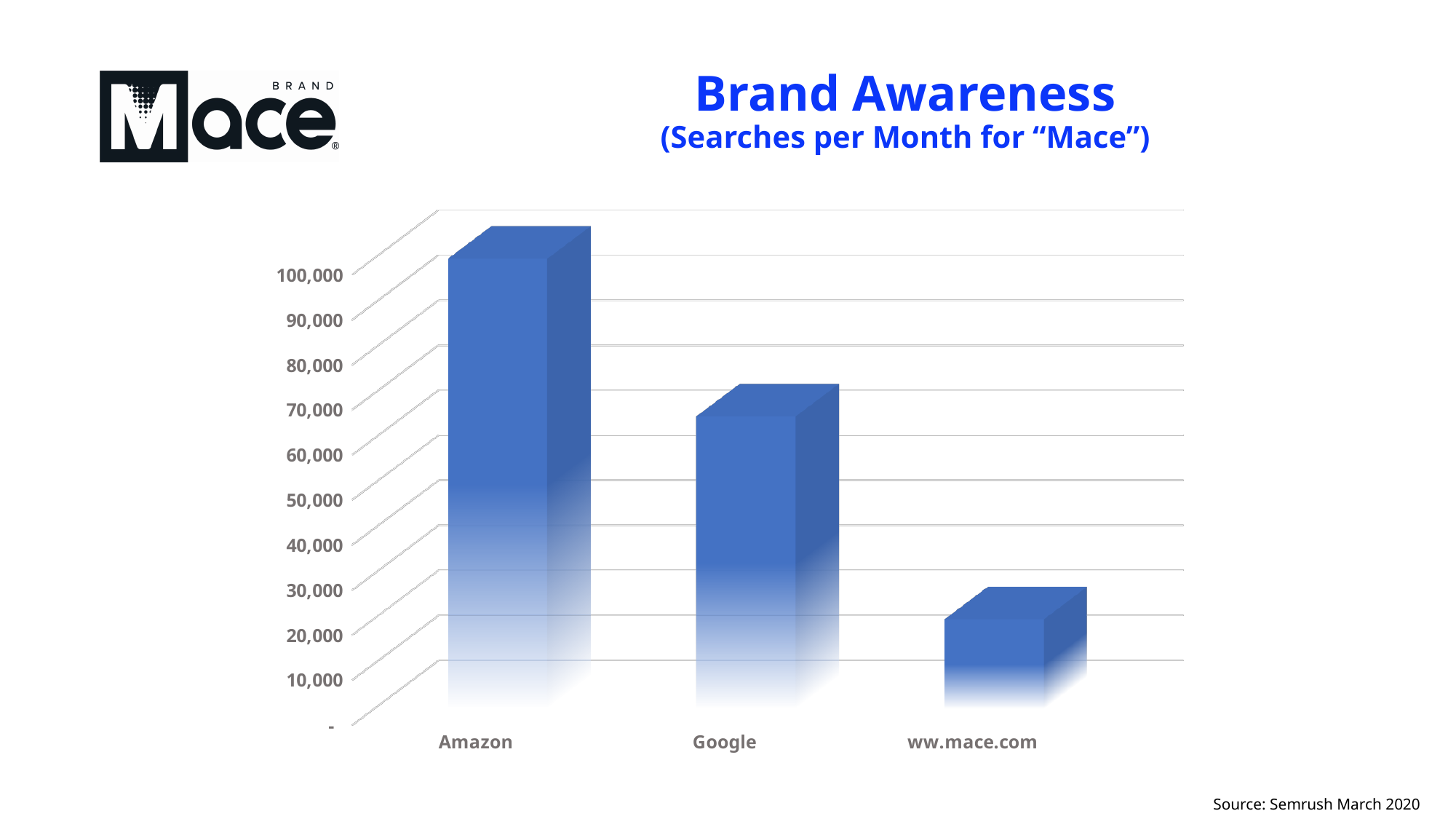
What is the title of the chart? Brand Awareness (Searches per Month for "Mace") Which category has the lowest number of searches per month? ww.mace.com Is the value for ww.mace.com greater or less than 30,000? less Which has more searches per month, Google or ww.mace.com? Google Which has more searches per month, Amazon or Google? Amazon What kind of chart is shown on the slide? bar chart How many categories are shown on the x axis of the chart? 3 Is the value for Google greater or less than 80,000? less Do the values rise or fall moving from left to right along the x axis? fall Which category has the highest number of searches per month? Amazon Is the value for Amazon greater or less than 90,000? greater